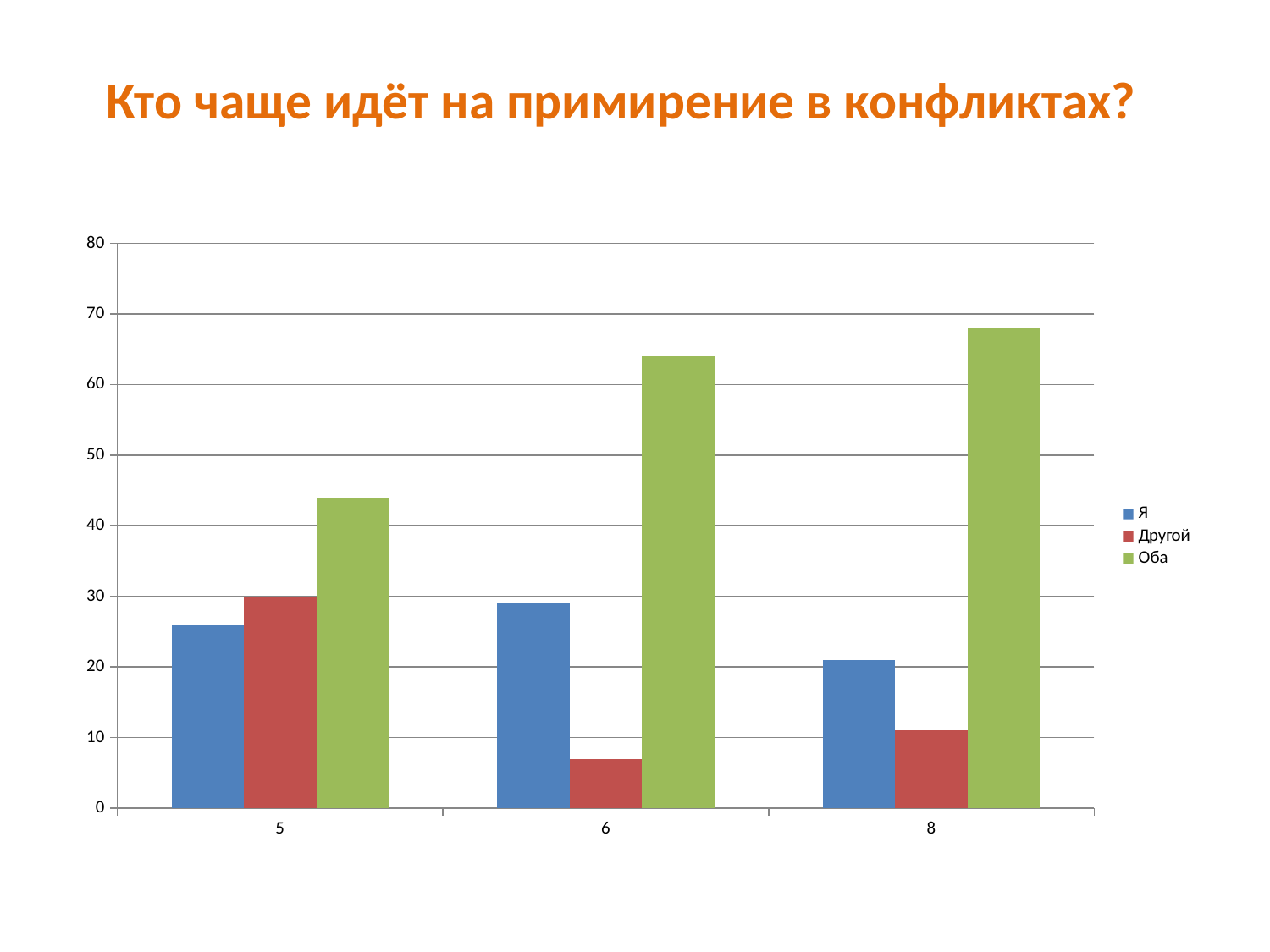
What is the title of the chart? Кто чаще идёт на примирение в конфликтах? Is the value for Другой in category 8 greater or less than 20? less How many series does the legend list? 3 In which category is the value for Другой the lowest? 6 In which category is the value for Оба the highest? 8 Which is larger in category 5: the value for Я or the value for Другой? Другой Which series has the lowest value in category 6? Другой Is the value for Оба in category 6 greater or less than 60? greater What kind of chart is shown on the slide? bar chart How many categories are shown on the x axis? 3 Which series has the highest value in category 8? Оба Which series is shown in green in the legend? Оба